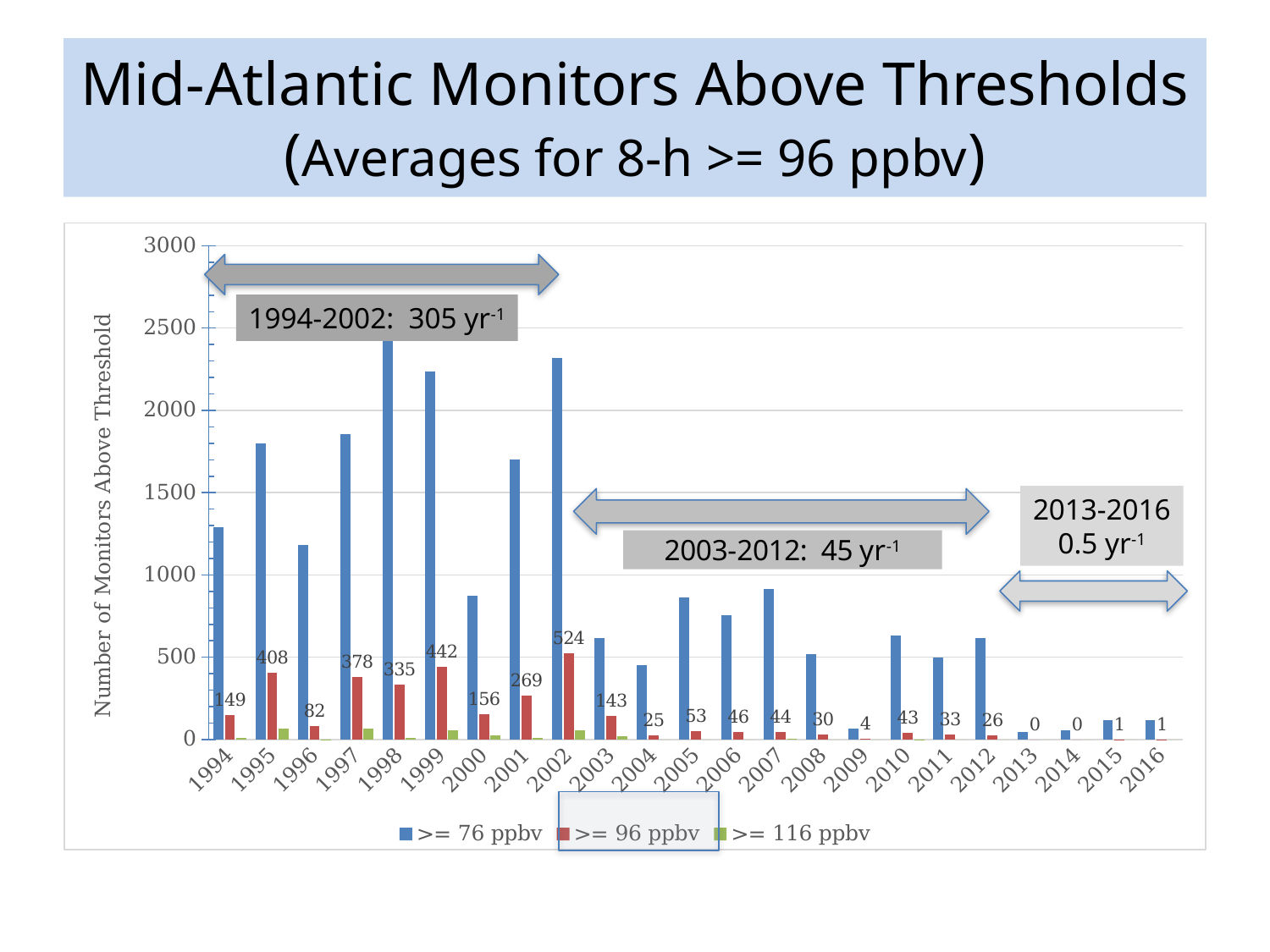
What is the value for the >= 96 ppbv series in 1995? 408 Which year has the larger >= 96 ppbv value, 1997 or 1998? 1997 What kind of chart is shown on the slide? bar chart How many years are shown on the x axis? 23 In which year is the >= 96 ppbv series highest? 2002 What is the difference between the >= 96 ppbv values for 2002 and 2003? 381 Is the value for the >= 76 ppbv series in 1998 greater or less than 2000? greater What is the value for the >= 96 ppbv series in 2002? 524 What is the value for the >= 96 ppbv series in 2010? 43 How many series does the legend list? 3 What is the title of the y axis? Number of Monitors Above Threshold Is the value for the >= 76 ppbv series in 2009 greater or less than 500? less